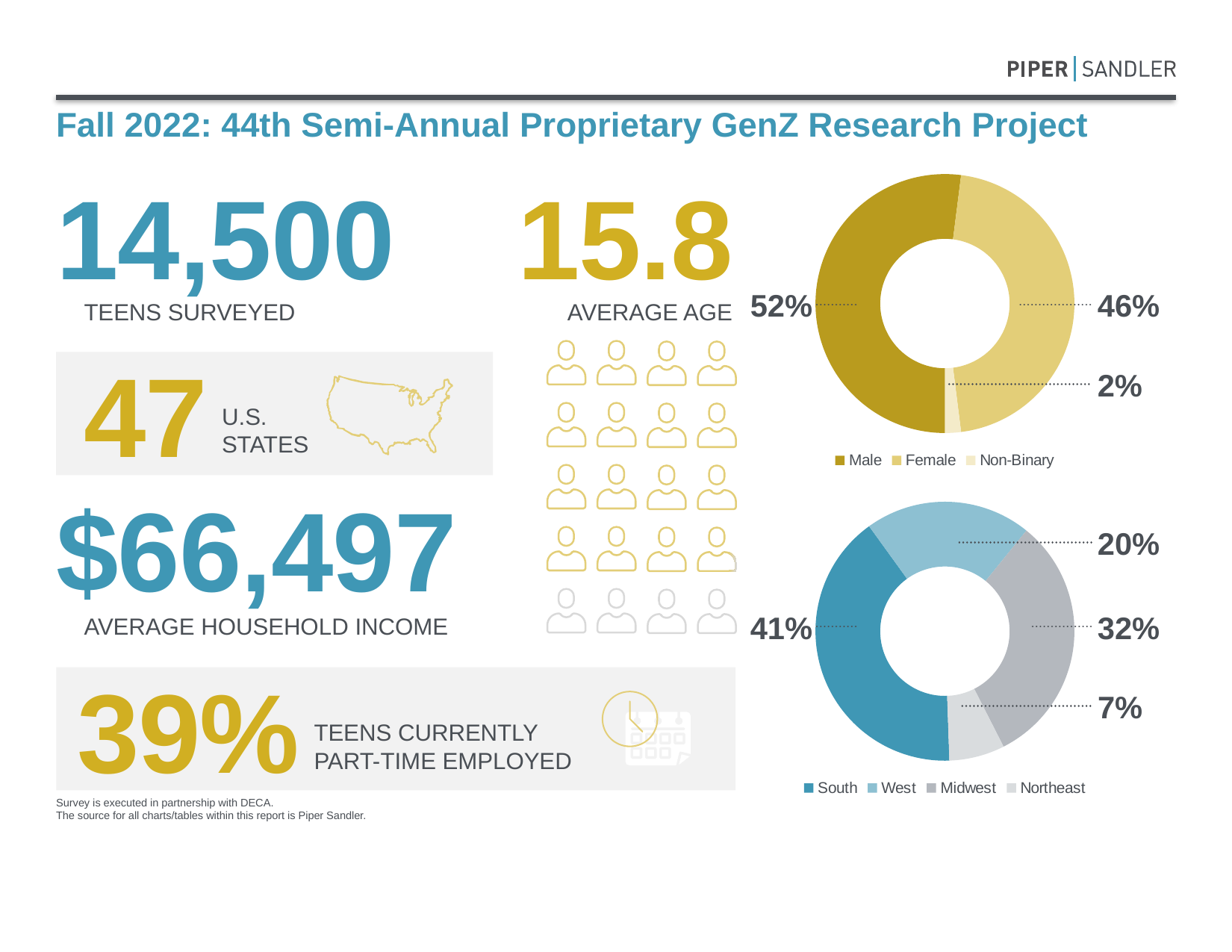
In the lower-right donut chart (South/West/Midwest/Northeast), what is the difference between the Midwest and West shares? 12% How many categories does the legend of the upper-right donut chart list? 3 In the upper-right donut chart (Male/Female/Non-Binary), what share is Female? 46% In the upper-right donut chart (Male/Female/Non-Binary), what is the difference between the Male and Female shares? 6% What kind of chart is the lower-right chart showing South, West, Midwest and Northeast? Donut (pie) chart In the upper-right donut chart (Male/Female/Non-Binary), what share is Non-Binary? 2% In the lower-right donut chart (South/West/Midwest/Northeast), what share is Midwest? 32% In the upper-right donut chart (Male/Female/Non-Binary), which category has the smallest share? Non-Binary In the upper-right donut chart (Male/Female/Non-Binary), what share is Male? 52% In the lower-right donut chart (South/West/Midwest/Northeast), which is larger, West or Northeast? West In the lower-right donut chart (South/West/Midwest/Northeast), which region has the largest share? South In the lower-right donut chart (South/West/Midwest/Northeast), what share is South? 41%